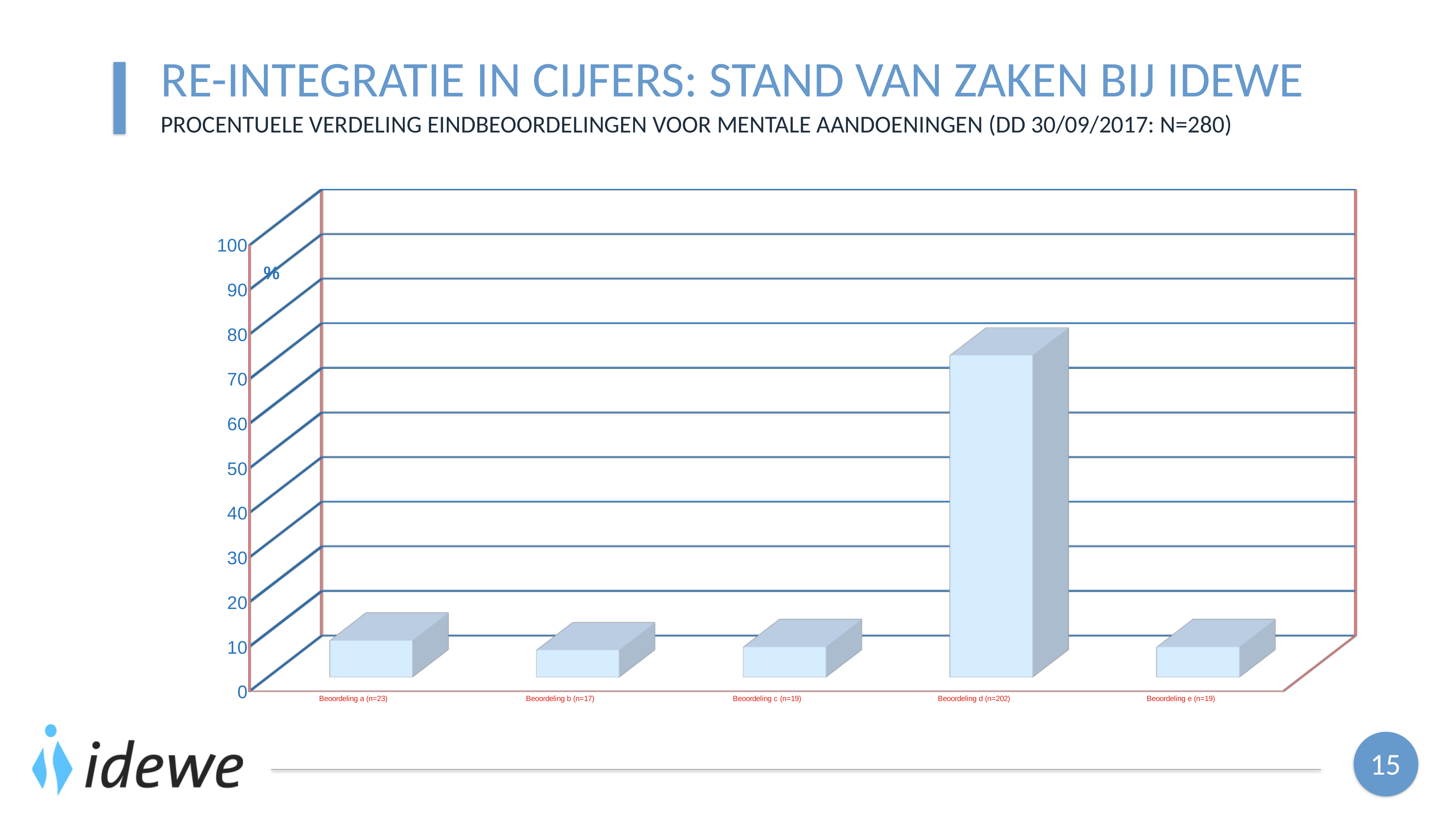
Which is larger, the value for Beoordeling a (n=23) or the value for Beoordeling d (n=202)? Beoordeling d (n=202) Is the value for Beoordeling b (n=17) greater or less than 30? less What unit is indicated on the vertical axis of the chart? % Which category has the highest bar in the chart? Beoordeling d (n=202) Which is larger, the value for Beoordeling d (n=202) or the value for Beoordeling c (n=19)? Beoordeling d (n=202) Is the value for Beoordeling d (n=202) greater or less than 50? greater Is the value for Beoordeling d (n=202) greater or less than 80? less What is the highest tick value shown on the vertical axis of the chart? 100 What kind of chart is shown on the slide? bar chart How many categories are plotted on the x axis of the chart? 5